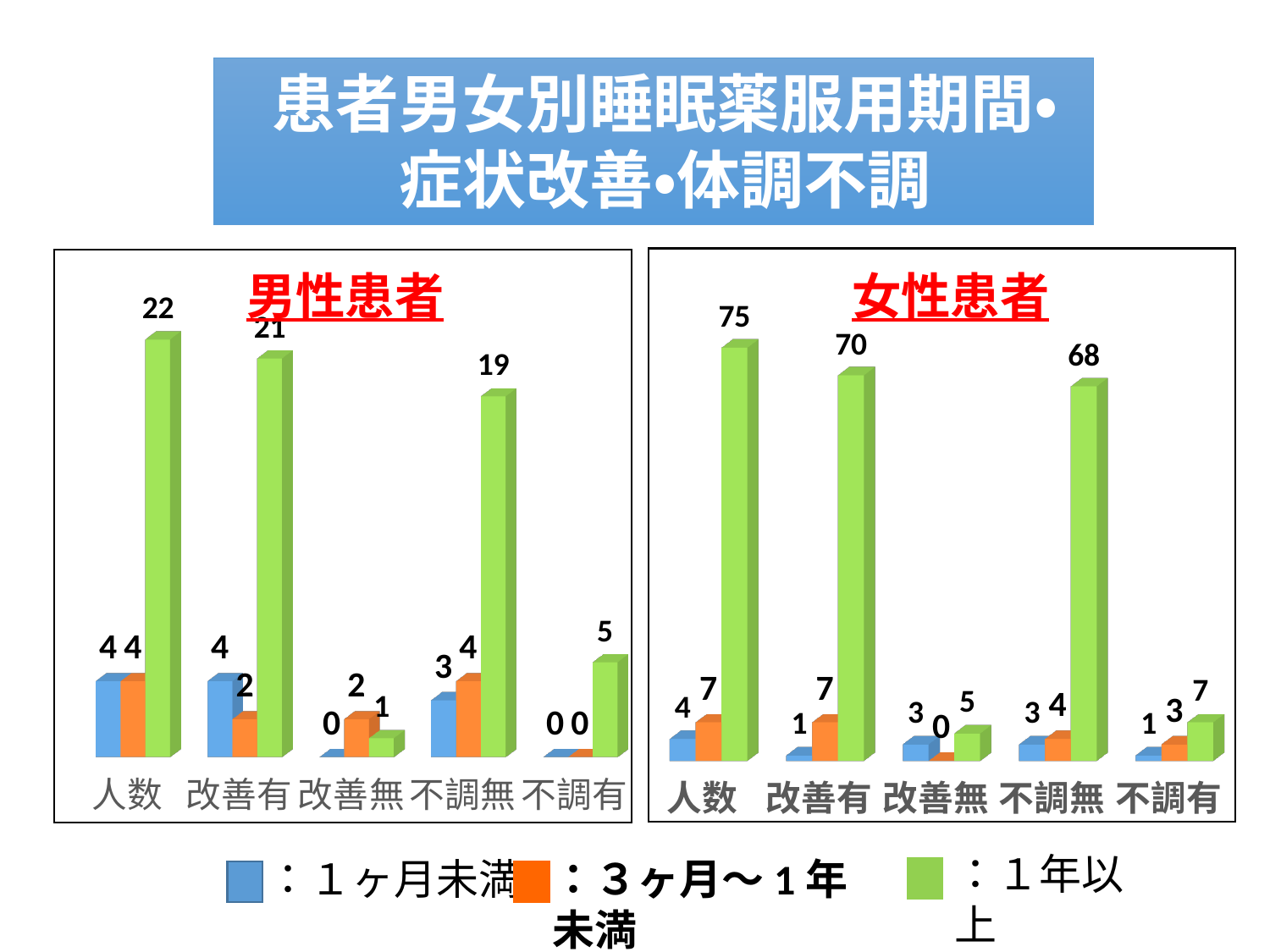
How many series does the legend at the bottom of the slide list? 3 In the 男性患者 chart, which is larger: the 1年以上 value for 改善有 or for 不調無? 改善有 In the 女性患者 chart, what is the value of the 3ヶ月～1年未満 series for 不調有? 3 In the 男性患者 chart, what is the total of the three series for 不調有? 5 Which colour represents the 3ヶ月～1年未満 series in the legend? orange In the 女性患者 chart, what is the value of the 1年以上 series for 改善有? 70 What kind of chart is the 男性患者 chart? bar chart In the 女性患者 chart, what is the difference between the 1年以上 values for 人数 and 不調無? 7 In the 男性患者 chart, which category has the highest value for the 1年以上 series? 人数 In the 男性患者 chart, what is the value of the 1年以上 series for 人数? 22 How many categories are shown on the x axis of the 女性患者 chart? 5 In the 女性患者 chart, which category has the lowest value for the 1年以上 series? 改善無